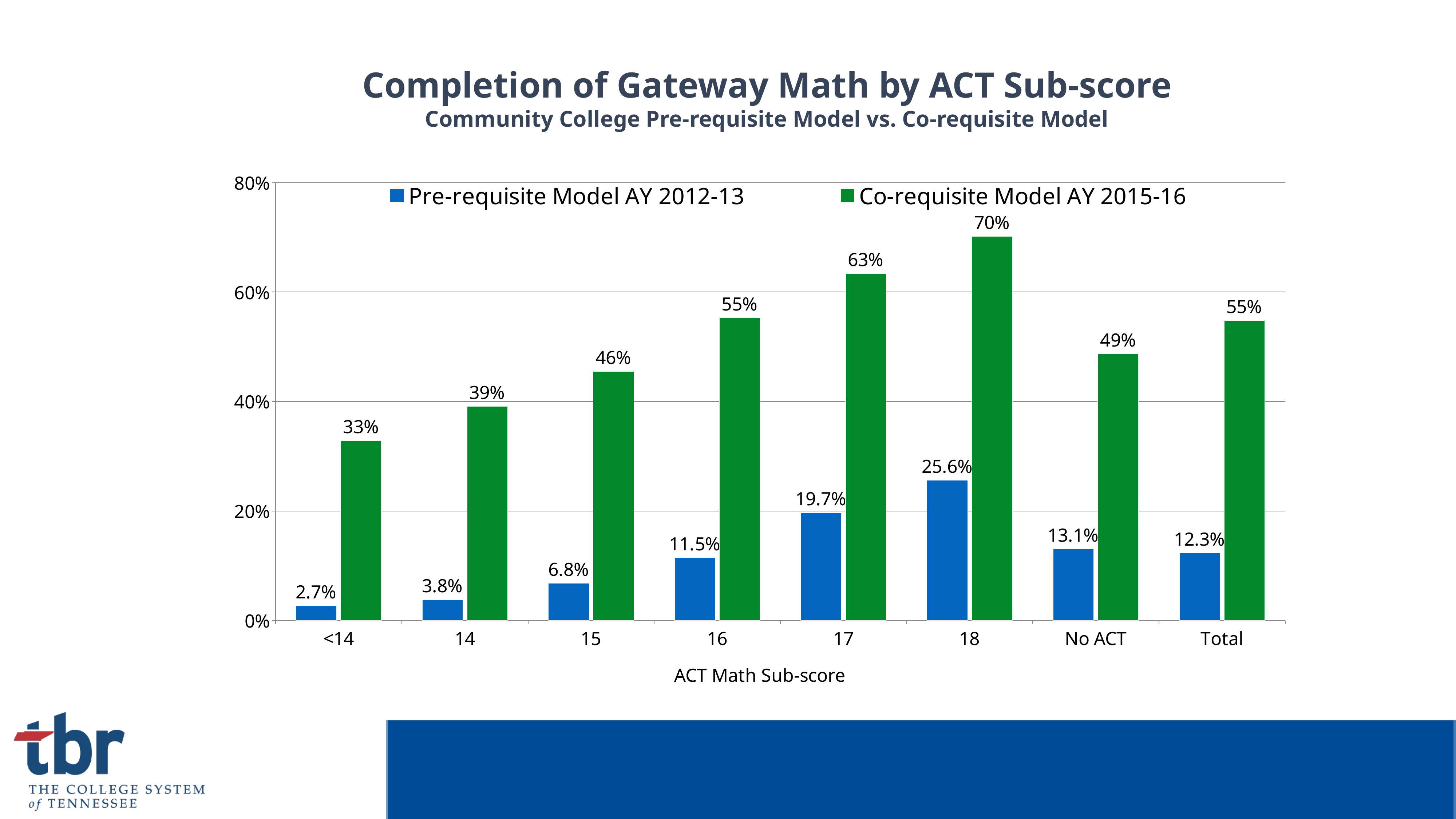
What is the Co-requisite Model AY 2015-16 completion rate for ACT Math sub-score 18? 70% How many series does the legend list? 2 What is the Pre-requisite Model AY 2012-13 value for the Total category? 12.3% What kind of chart is shown on the slide? Bar chart What is the x-axis title of the chart? ACT Math Sub-score What is the Pre-requisite Model AY 2012-13 completion rate for ACT Math sub-score 16? 11.5% What is the difference between the Co-requisite and Pre-requisite completion rates for the Total category? 42.7% How many categories are shown on the x axis? 8 Is the Co-requisite Model AY 2015-16 value for sub-score 15 greater or less than 40%? greater Which category has the lowest Pre-requisite Model AY 2012-13 completion rate? <14 Which ACT Math sub-score category has the highest Co-requisite Model AY 2015-16 completion rate? 18 Which is larger: the Pre-requisite Model value for 18 or the Pre-requisite Model value for No ACT? 18